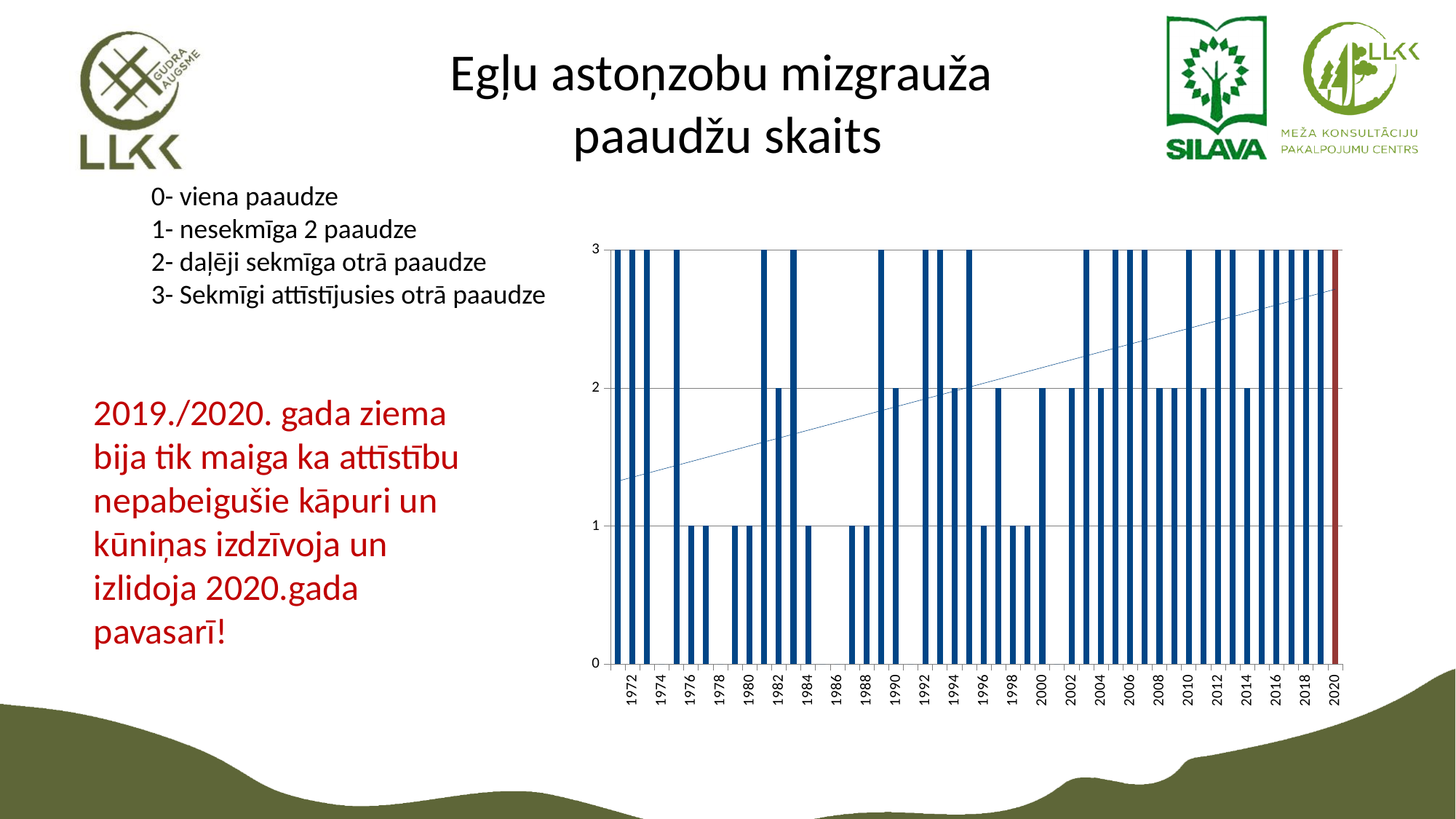
Which is larger, the value for 2000 or the value for 2020? 2020 What is the value for 2010? 3 What is the value for 1996? 1 What is the value for 1986? 0 What is the value for 1984? 1 What is the value for 2000? 2 What is the difference between the value for 2020 and the value for 1996? 2 Is the value for 2016 greater or less than 2? greater What is the value for 2020? 3 What kind of chart is shown on the slide? bar chart Does the trend line drawn across the chart rise or fall from left to right? rise What colour is the bar for 2020? red